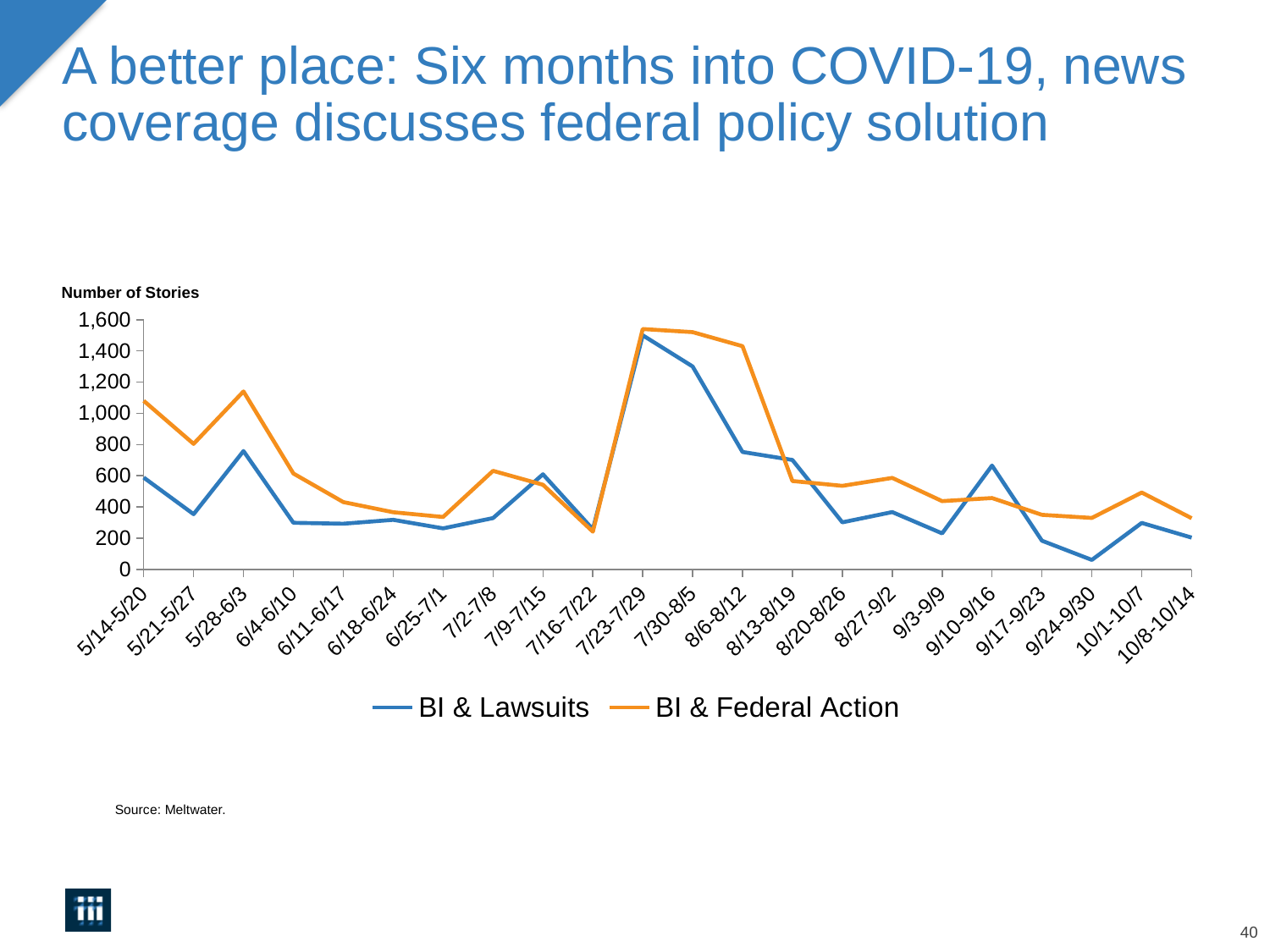
Do the values for BI & Federal Action rise or fall from 7/23-7/29 to 8/13-8/19? fall How many weekly periods are shown on the x axis? 22 Is the value for BI & Federal Action in 7/23-7/29 greater or less than 1,400? greater Is the value for BI & Lawsuits in 9/24-9/30 greater or less than 200? less How many series does the legend list? 2 In which period does the BI & Lawsuits series reach its highest value? 7/23-7/29 In 5/14-5/20, which series has the higher value, BI & Lawsuits or BI & Federal Action? BI & Federal Action In which period does the BI & Lawsuits series reach its lowest value? 9/24-9/30 Is the value for BI & Federal Action in 5/28-6/3 greater or less than 1,000? greater In which period does the BI & Federal Action series reach its highest value? 7/23-7/29 What kind of chart is shown on the slide? line chart What is the label on the vertical axis of the chart? Number of Stories